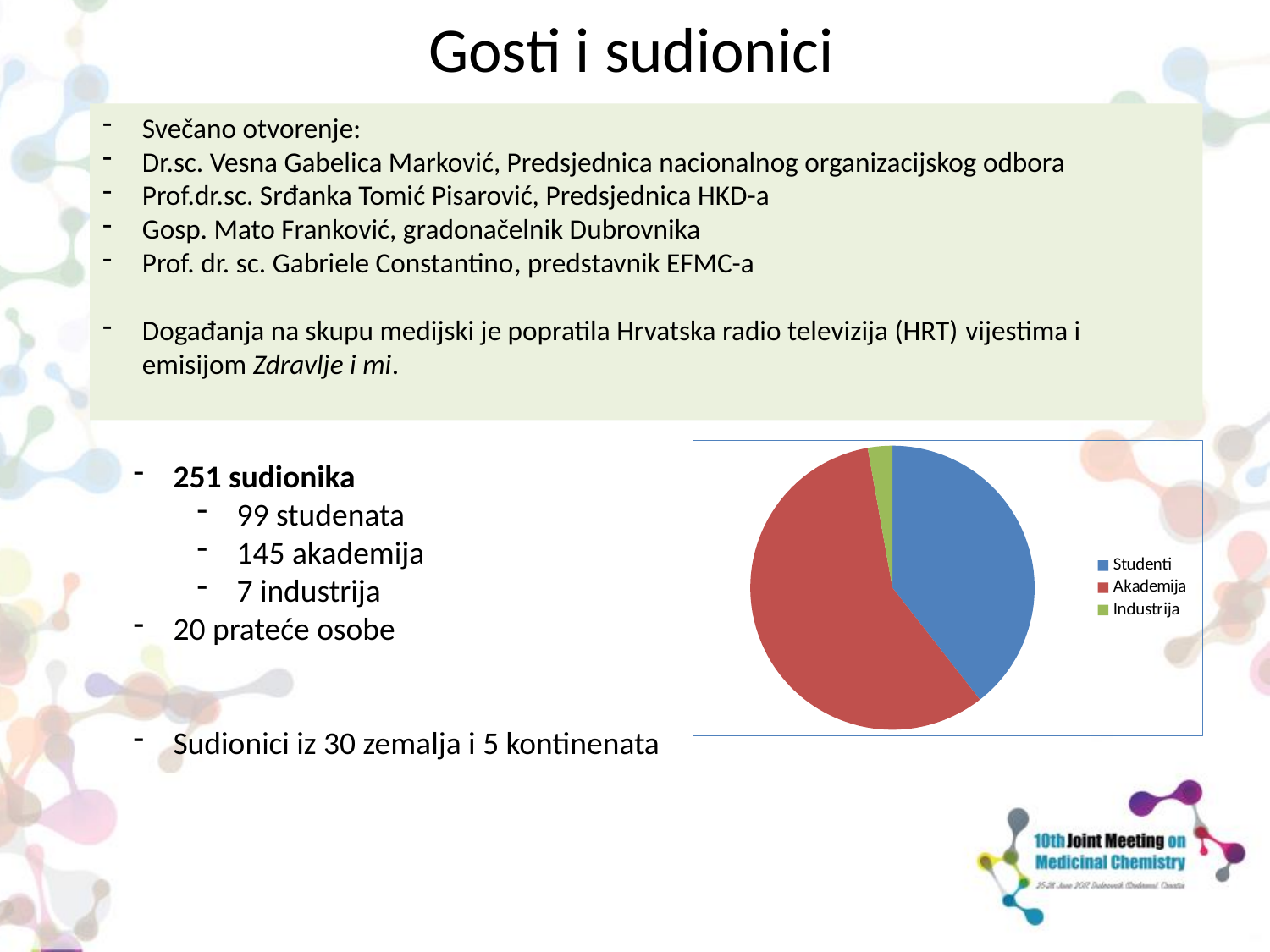
How many entries does the legend of the pie chart list? 3 What kind of chart is shown on the slide? Pie chart According to the slide, how many participants does the Studenti slice represent? 99 Which slice is larger in the pie chart, Akademija or Studenti? Akademija Using the numbers on the slide, how many more participants are in Akademija than in Studenti? 46 Which category has the smallest slice in the pie chart? Industrija Which category has the largest slice in the pie chart? Akademija According to the slide, how many participants does the Akademija slice represent? 145 What colour is the Akademija slice in the pie chart? Red Which slice is larger in the pie chart, Studenti or Industrija? Studenti According to the slide, how many participants does the Industrija slice represent? 7 How many slices does the pie chart have? 3